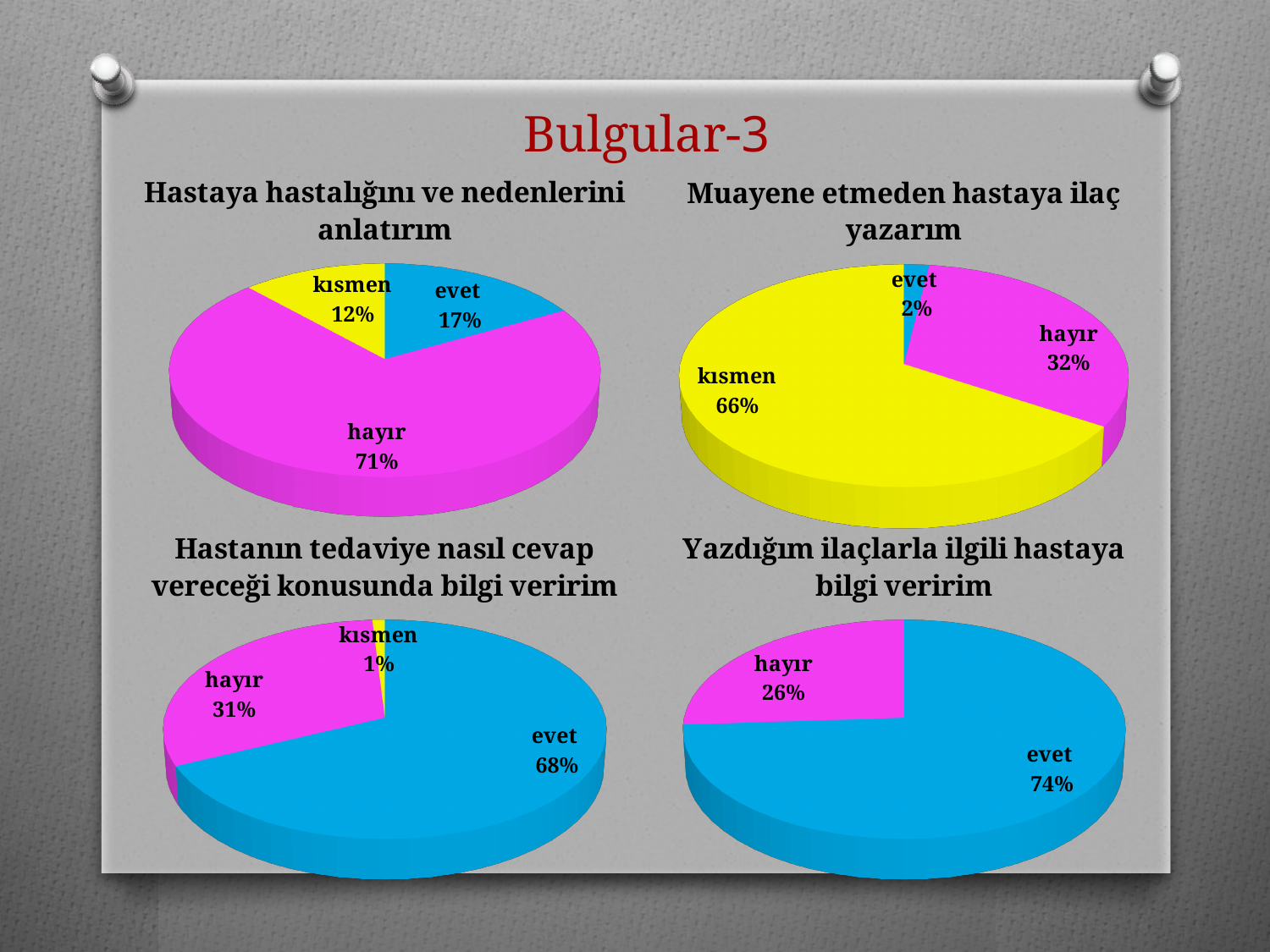
In the chart titled 'Yazdığım ilaçlarla ilgili hastaya bilgi veririm', what is the share for 'hayır'? 26% In the chart titled 'Muayene etmeden hastaya ilaç yazarım', what is the difference between the 'kısmen' and 'hayır' shares? 34% In the chart titled 'Hastaya hastalığını ve nedenlerini anlatırım', what is the share for 'kısmen'? 12% In the chart titled 'Hastanın tedaviye nasıl cevap vereceği konusunda bilgi veririm', which category has the smallest slice? kısmen In the chart titled 'Hastanın tedaviye nasıl cevap vereceği konusunda bilgi veririm', what is the share for 'evet'? 68% In the chart titled 'Yazdığım ilaçlarla ilgili hastaya bilgi veririm', how many slices does the pie have? 2 How many pie charts are shown on the slide? 4 What kind of chart is the chart titled 'Yazdığım ilaçlarla ilgili hastaya bilgi veririm'? pie chart In the chart titled 'Muayene etmeden hastaya ilaç yazarım', what is the share for 'evet'? 2% In the chart titled 'Muayene etmeden hastaya ilaç yazarım', which category has the largest slice? kısmen In the chart titled 'Hastaya hastalığını ve nedenlerini anlatırım', which is larger, 'evet' or 'kısmen'? evet In the chart titled 'Hastaya hastalığını ve nedenlerini anlatırım', what is the share for 'hayır'? 71%